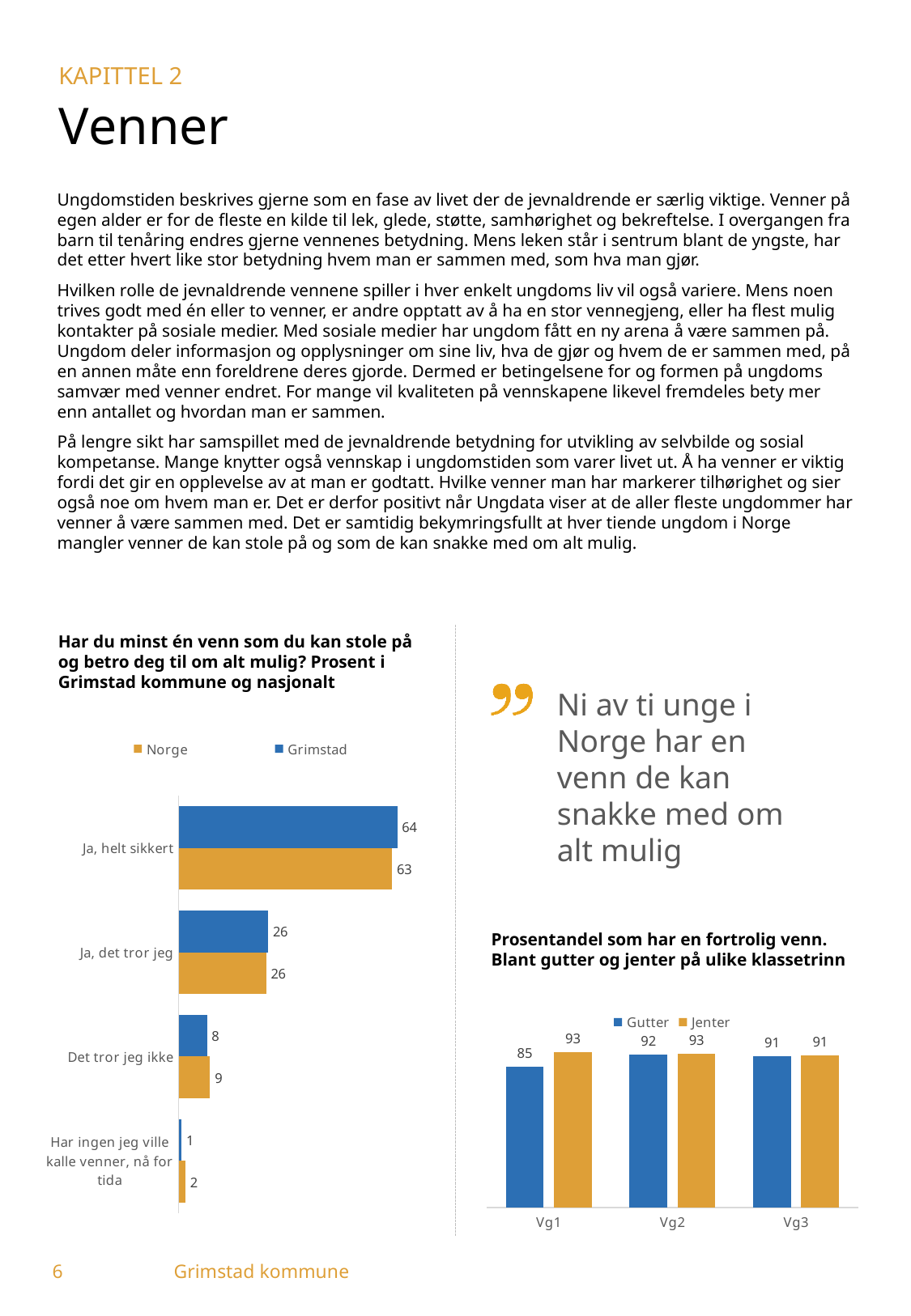
In the right chart (Prosentandel som har en fortrolig venn), what is the difference between Jenter and Gutter at Vg1? 8 In the left chart (Har du minst én venn som du kan stole på...), how many series does the legend list? 2 In the left chart (Har du minst én venn som du kan stole på...), what is the value for Norge for 'Det tror jeg ikke'? 9 In the left chart (Har du minst én venn som du kan stole på...), how many categories are shown? 4 In the left chart (Har du minst én venn som du kan stole på...), what is the difference between the Grimstad and Norge values for 'Ja, helt sikkert'? 1 In the left chart (Har du minst én venn som du kan stole på...), which category has the highest value for Grimstad? Ja, helt sikkert What kind of chart is the left chart (Har du minst én venn som du kan stole på...)? Bar chart In the right chart (Prosentandel som har en fortrolig venn), which colour represents Jenter? Orange In the right chart (Prosentandel som har en fortrolig venn), which is larger at Vg1, Gutter or Jenter? Jenter In the right chart (Prosentandel som har en fortrolig venn), what is the value for Gutter at Vg1? 85 In the left chart (Har du minst én venn som du kan stole på...), what is the value for Grimstad for 'Ja, helt sikkert'? 64 In the left chart (Har du minst én venn som du kan stole på...), which category has the lowest value for Norge? Har ingen jeg ville kalle venner, nå for tida